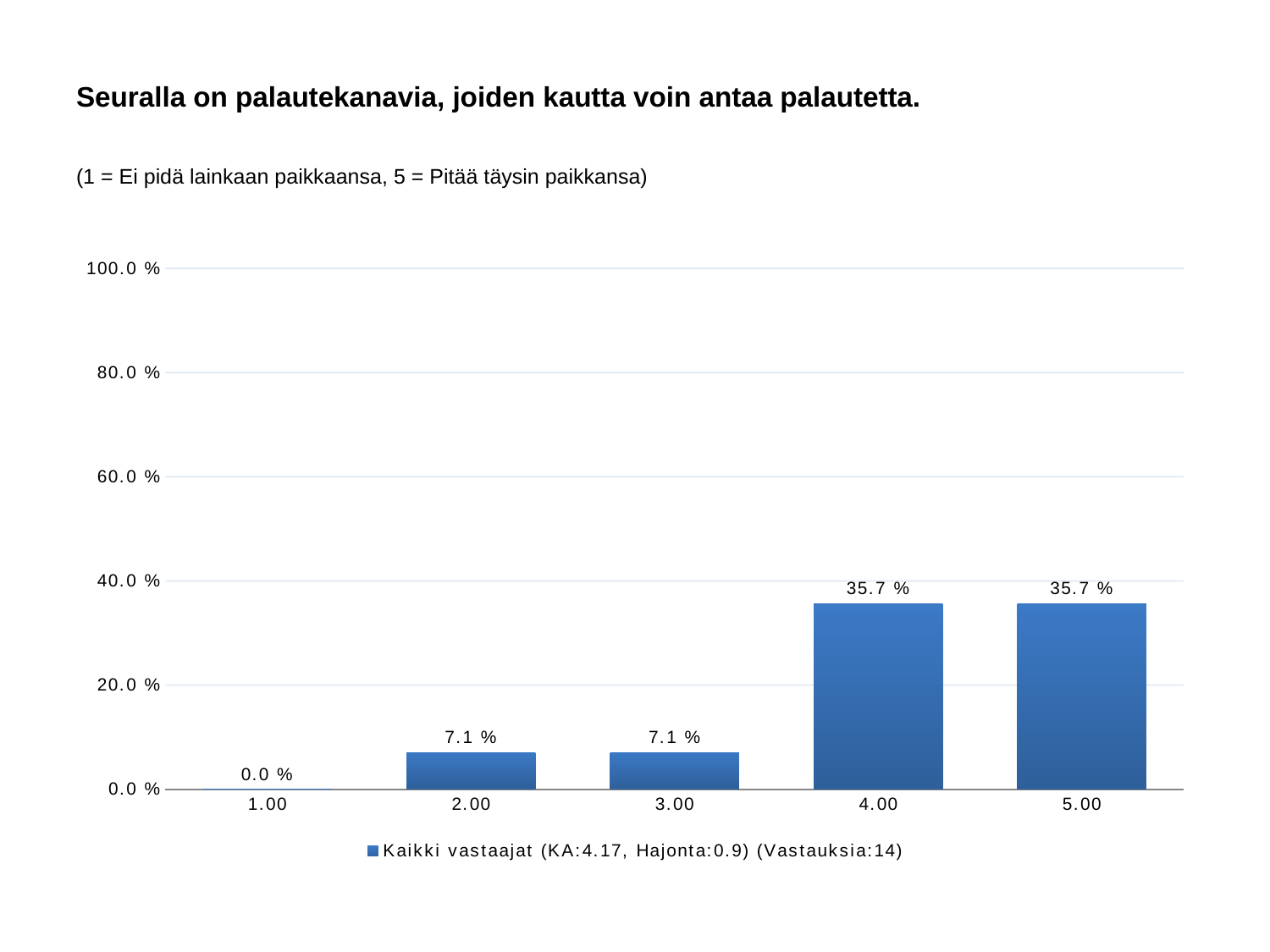
Do the values generally rise or fall from 1.00 to 5.00? rise How many categories are shown on the x axis? 5 Is the value for 5.00 greater or less than 20.0 %? greater How many series does the legend list? 1 Which category has the lowest value? 1.00 Which is larger, the value for 2.00 or the value for 5.00? 5.00 What is the difference between the values for 4.00 and 3.00? 28.6 % What is the number of responses (Vastauksia) given in the legend? 14 What is the value for category 1.00? 0.0 % What kind of chart is shown? bar chart What is the value for category 4.00? 35.7 % What is the value for category 2.00? 7.1 %